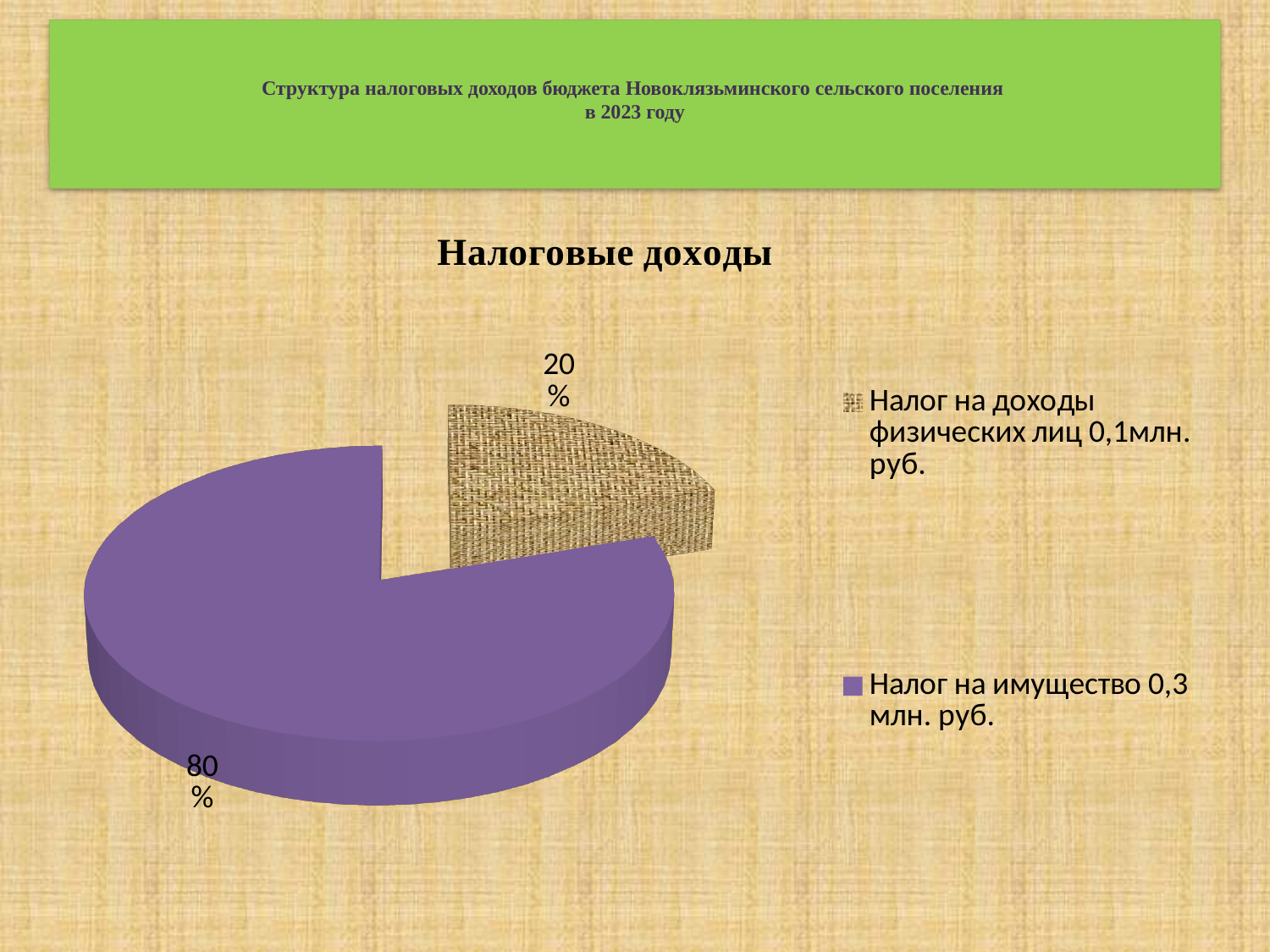
Which slice is the largest? Налог на имущество 0,3 млн. руб. How many slices does the pie chart have? 2 Which is larger: the share for Налог на имущество or the share for Налог на доходы физических лиц? Налог на имущество What colour is the slice for Налог на имущество 0,3 млн. руб.? Purple What is the difference in percentage points between the two slices? 60 How many entries does the legend list? 2 What is the title of the chart? Налоговые доходы Which slice is the smallest? Налог на доходы физических лиц 0,1млн. руб. What share of the pie is labelled for Налог на доходы физических лиц 0,1млн. руб.? 20% What kind of chart is shown on the slide? Pie chart What share of the pie is labelled for Налог на имущество 0,3 млн. руб.? 80%